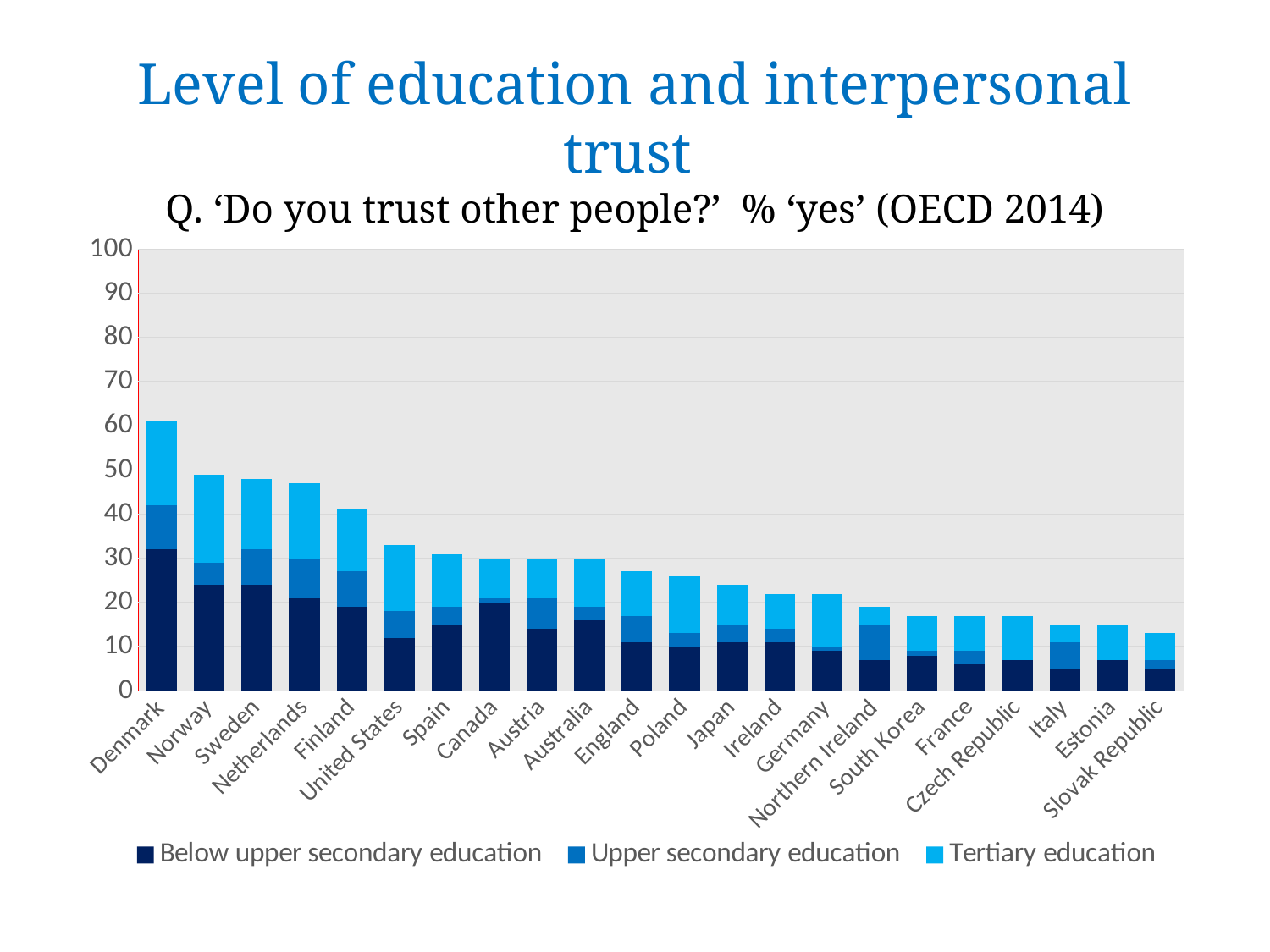
What kind of chart is shown on the slide? stacked bar chart Do the total bar heights rise or fall moving from left to right along the x axis? fall How many series does the legend list? 3 How many countries are shown on the x axis of the chart? 22 Which country has the highest total bar in the chart? Denmark Which country has the lowest total bar in the chart? Slovak Republic Which has the larger total bar, Finland or United States? Finland Which series is shown in the darkest blue colour in the legend? Below upper secondary education Is the total bar for Denmark greater or less than 50? greater Is the total bar for Italy greater or less than 20? less Is the total bar for United States greater or less than 40? less